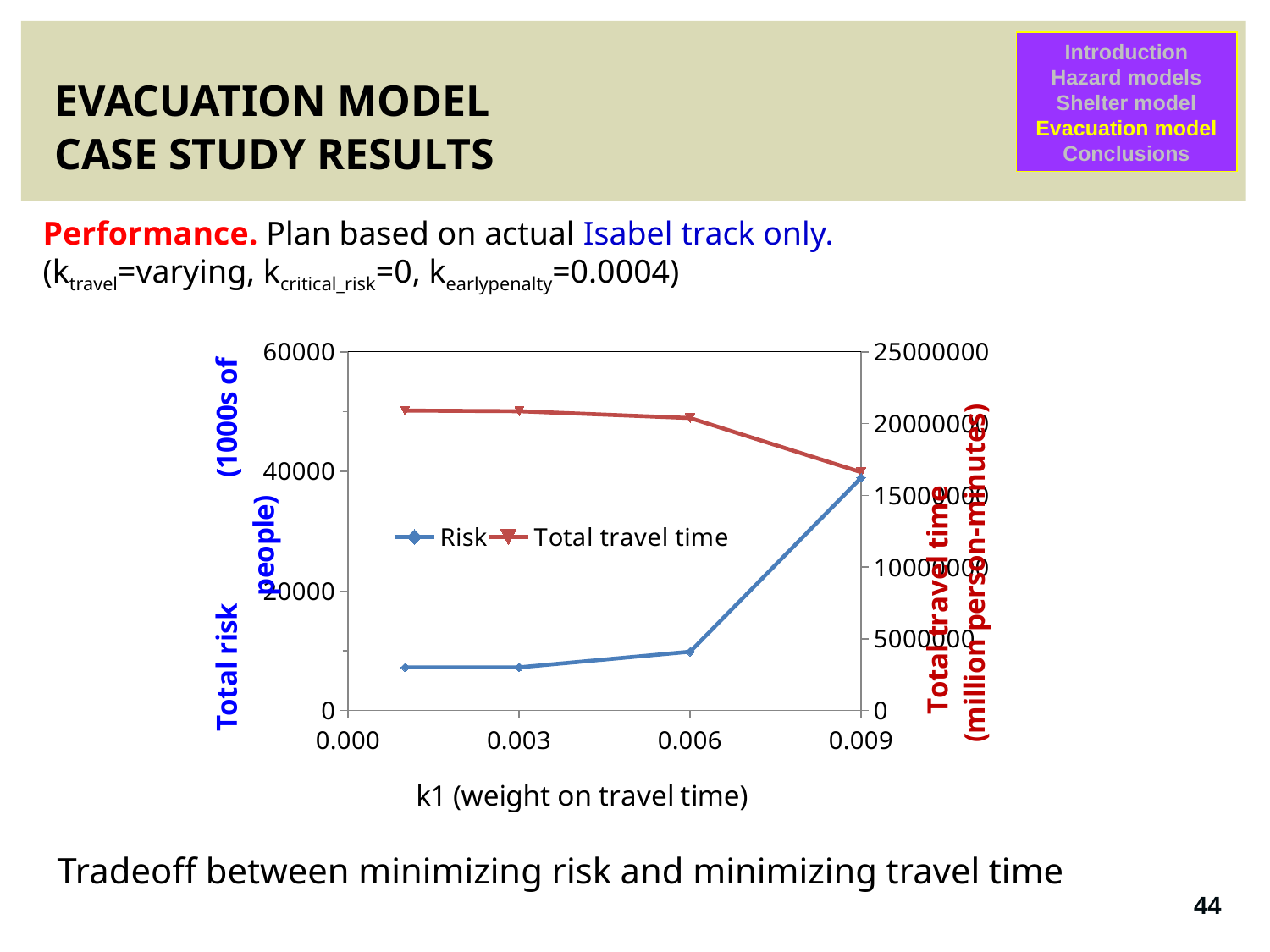
What are the two series named in the chart's legend? Risk and Total travel time Does the Total travel time series rise or fall as k1 increases along the x axis? fall What is the title of the chart's x axis? k1 (weight on travel time) At which k1 value is Risk highest? 0.009 What kind of chart is shown on the slide? line chart Is the Risk value at k1 = 0.003 greater or less than 20000? less Is the Risk value at k1 = 0.009 greater or less than 20000? greater Is the Total travel time value at k1 = 0.009 greater or less than 20000000? less How many data points are plotted for the Risk series? 4 Does the Risk series rise or fall as k1 increases along the x axis? rise At which k1 value is Total travel time lowest? 0.009 How many series does the chart's legend list? 2